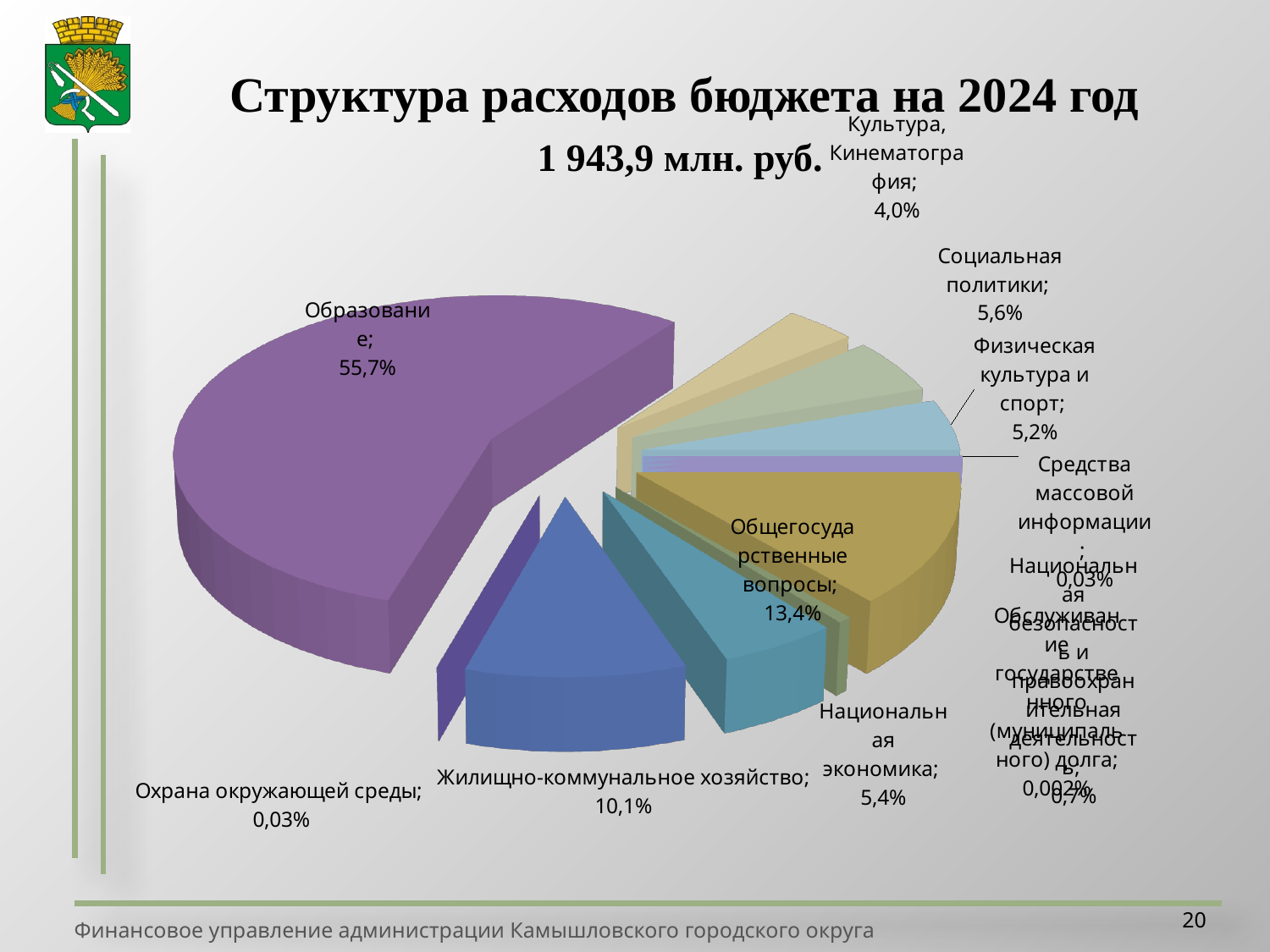
What share of expenditures goes to Жилищно-коммунальное хозяйство? 10,1% What total budget expenditure amount is stated under the chart title? 1 943,9 млн. руб. What share of expenditures goes to Социальная политика? 5,6% Which has a larger share: Физическая культура и спорт or Национальная экономика? Национальная экономика What share of expenditures goes to Общегосударственные вопросы? 13,4% Which category has the largest share of the 2024 budget expenditures? Образование What share of expenditures goes to Образование? 55,7% What kind of chart is shown on the slide? pie chart What share of expenditures goes to Охрана окружающей среды? 0,03% What is the title of the chart? Структура расходов бюджета на 2024 год By how many percentage points does the share of Образование exceed the share of Общегосударственные вопросы? 42,3 What share of expenditures goes to Культура, Кинематография? 4,0%